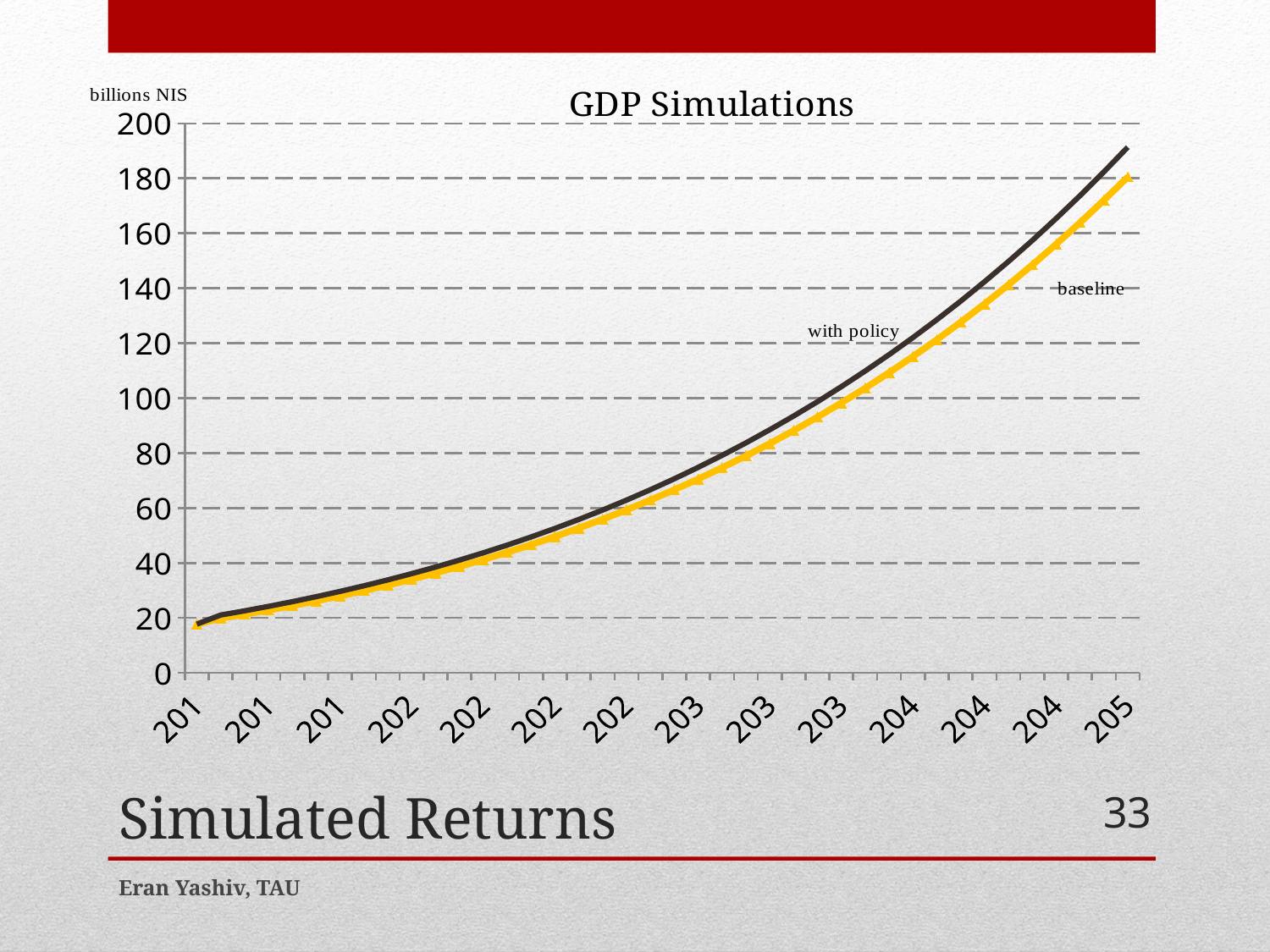
What is the title of the chart? GDP Simulations Is the starting value of the 'with policy' series greater or less than 60? less How many series are plotted in the GDP Simulations chart? 2 At the right end of the chart, which series is higher: 'with policy' or 'baseline'? with policy Is the final value of the 'with policy' series greater or less than 180? greater Is the starting value of the 'baseline' series greater or less than 40? less What kind of chart is shown on the slide? line chart What is the maximum value shown on the vertical axis of the chart? 200 Do the values of the 'with policy' series rise or fall along the x axis? rise What unit is shown for the vertical axis of the chart? billions NIS Do the values of the 'baseline' series rise or fall along the x axis? rise